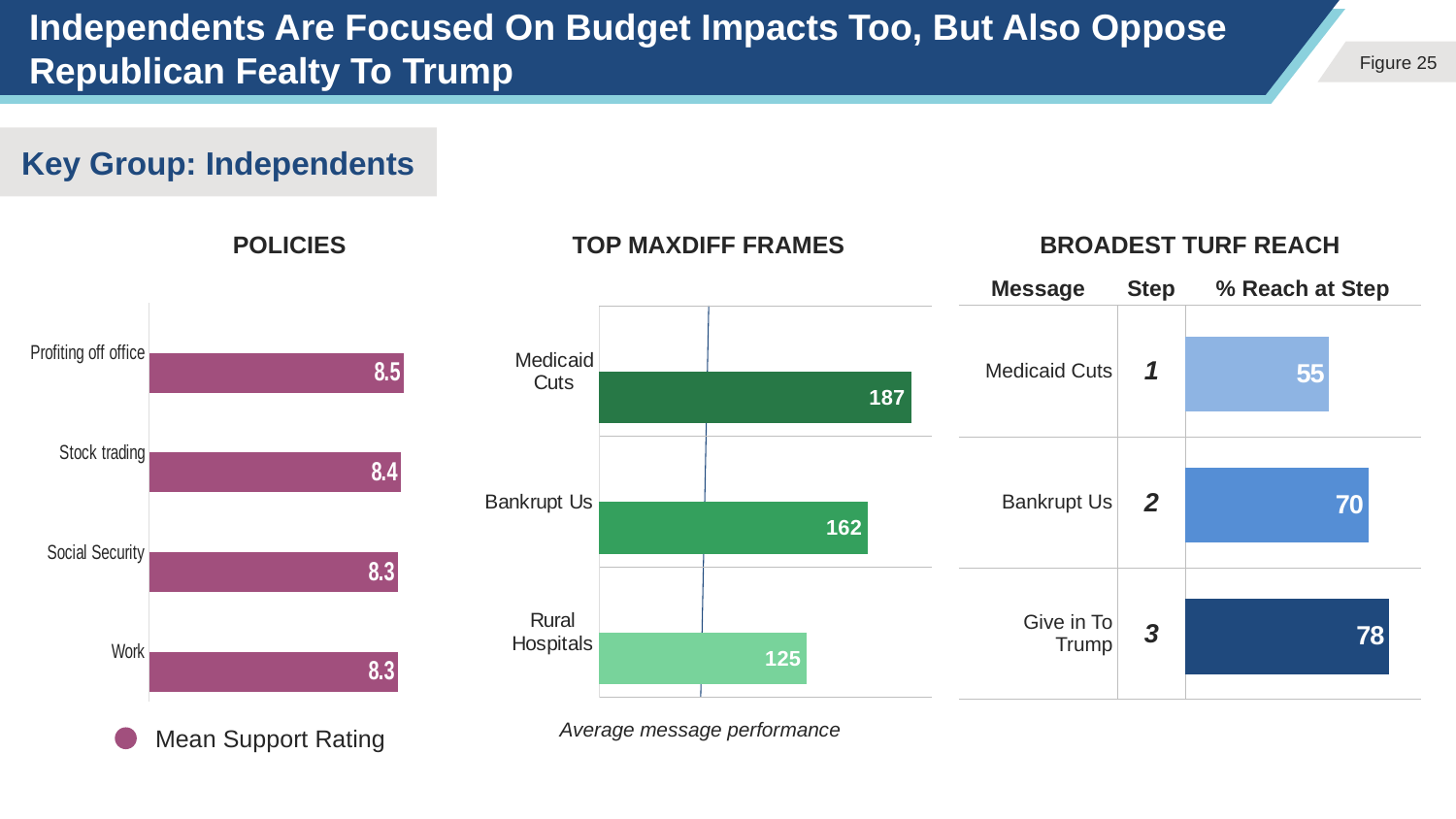
In the TOP MAXDIFF FRAMES chart, what is the difference between Medicaid Cuts and Rural Hospitals? 62 In the BROADEST TURF REACH chart, what is the % reach at step 3 (Give in To Trump)? 78 In the TOP MAXDIFF FRAMES chart, which frame has the lowest value? Rural Hospitals In the BROADEST TURF REACH chart, which is larger, the reach for Medicaid Cuts or for Bankrupt Us? Bankrupt Us In the POLICIES chart, what is the difference between the ratings for Profiting off office and Work? 0.2 In the POLICIES chart, what series does the legend list? Mean Support Rating In the POLICIES chart, which policy has the highest mean support rating? Profiting off office In the POLICIES chart, how many policies are shown? 4 In the TOP MAXDIFF FRAMES chart, what is the value for Bankrupt Us? 162 What kind of chart is the TOP MAXDIFF FRAMES chart? Bar chart In the POLICIES chart, what is the mean support rating for Profiting off office? 8.5 In the BROADEST TURF REACH chart, how many messages are listed? 3